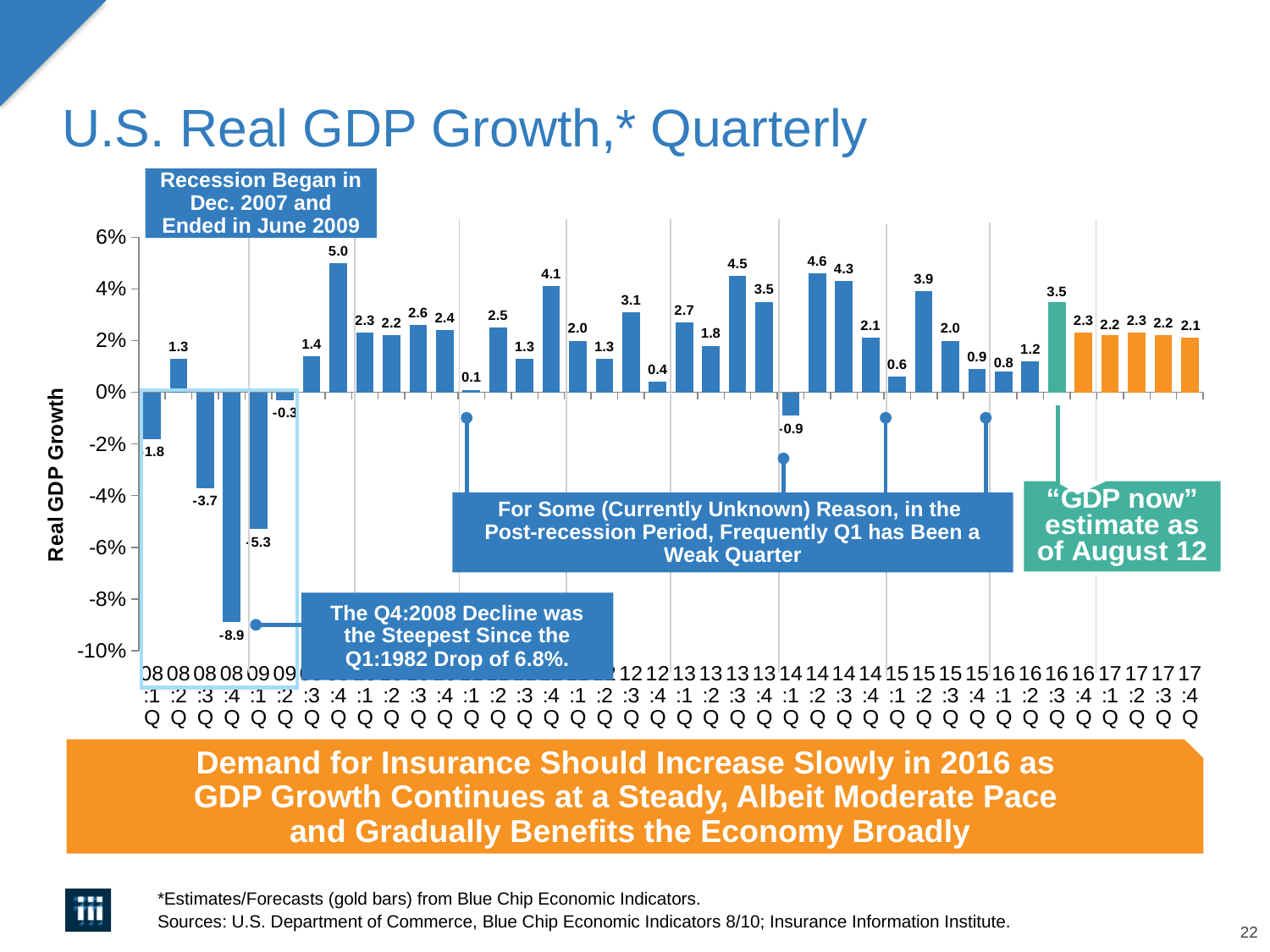
What is the highest real GDP growth value shown on the chart? 5.0 Which is larger, the value for 15:2Q or the value for 15:3Q? 15:2Q What kind of chart is shown on the slide? bar chart What is the real GDP growth value for 14:1Q? -0.9 What is the difference between the values for 13:3Q and 13:4Q? 1.0 What is the real GDP growth value for 14:2Q? 4.6 How many quarterly bars are plotted on the chart? 40 What is the real GDP growth value for 17:4Q? 2.1 What is the real GDP growth value for 08:4Q? -8.9 Do the values rise or fall from 16:1Q to 16:3Q? rise Which quarter has the lowest real GDP growth value? 08:4Q What is the real GDP growth value for 16:3Q? 3.5